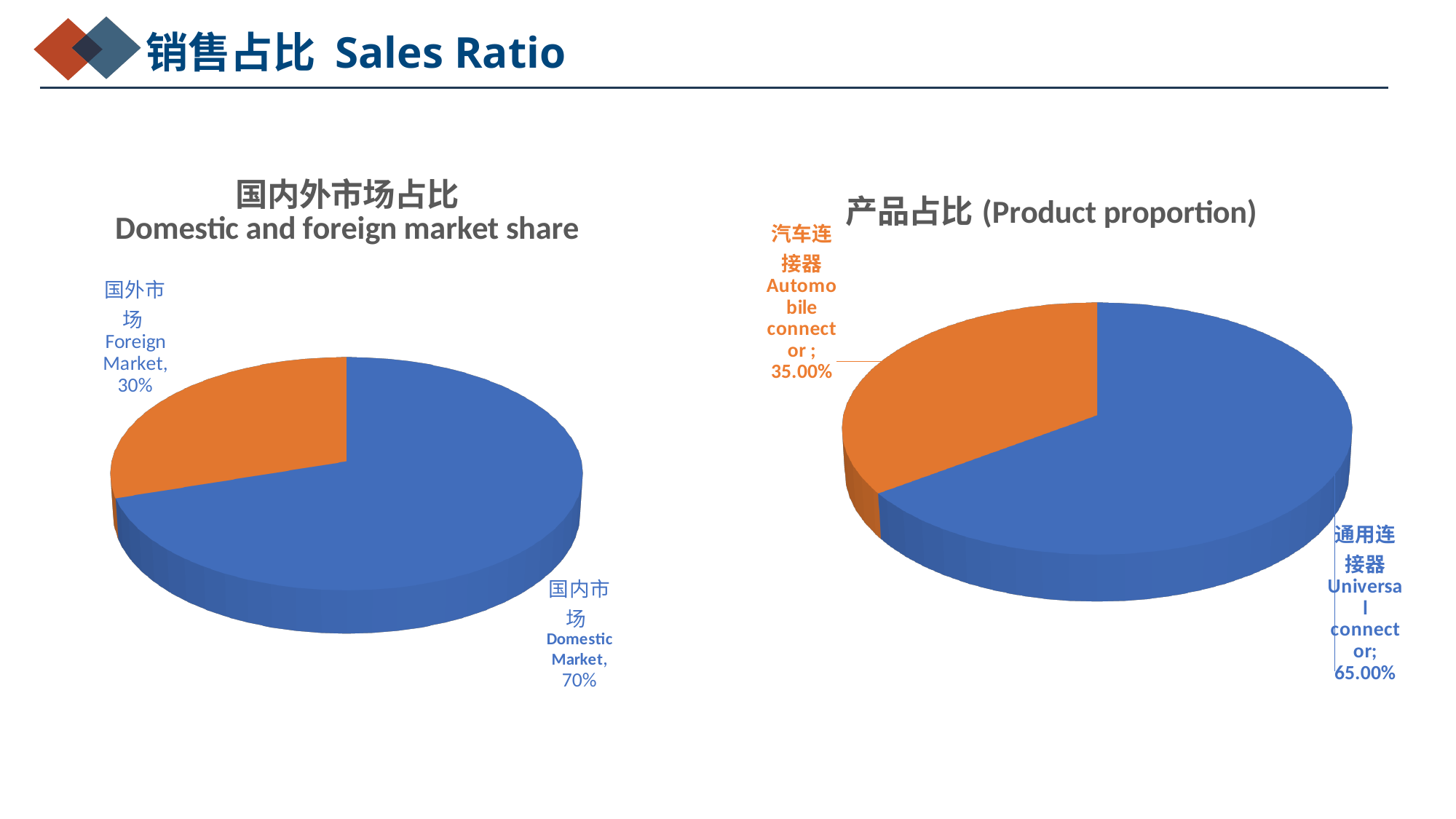
In the 'Product proportion' chart, which is larger: Universal connector or Automobile connector? Universal connector What type of chart is the 'Domestic and foreign market share' chart? Pie chart In the 'Domestic and foreign market share' chart, what is the difference between the Domestic Market and Foreign Market shares? 40% In the 'Domestic and foreign market share' chart, what is the value for Foreign Market? 30% In the 'Domestic and foreign market share' chart, which category has the largest share? Domestic Market In the 'Product proportion' chart, what is the value for Automobile connector? 35.00% In the 'Domestic and foreign market share' chart, what is the value for Domestic Market? 70% In the 'Product proportion' chart, what is the difference between the Universal connector and Automobile connector shares? 30.00% In the 'Domestic and foreign market share' chart, what colour is the Foreign Market slice? Orange In the 'Product proportion' chart, what is the value for Universal connector? 65.00% How many slices does the 'Product proportion' pie chart have? 2 In the 'Product proportion' chart, which category has the smallest share? Automobile connector